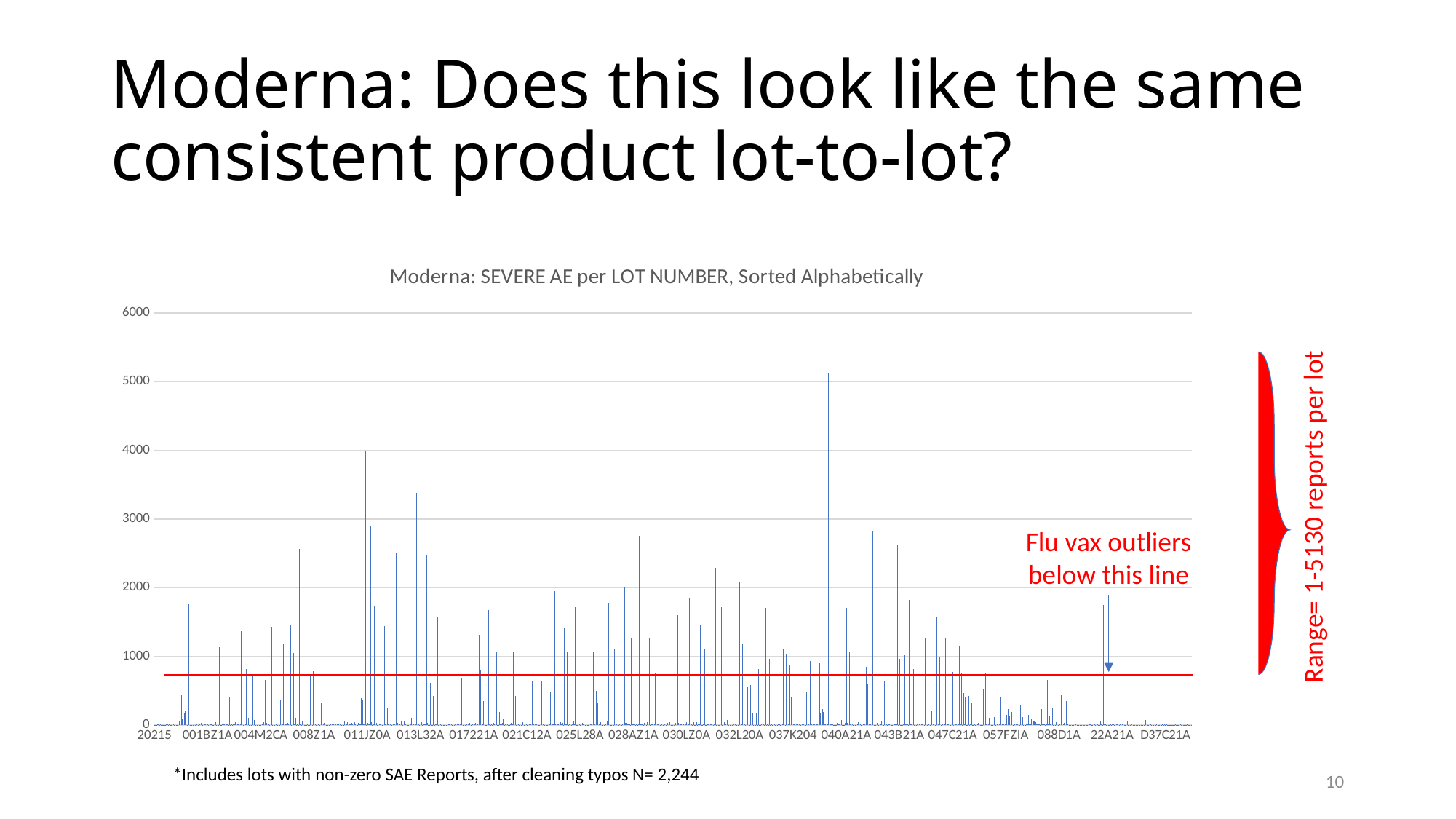
What is the last lot number label shown on the horizontal axis? D37C21A What kind of chart is shown on the slide? bar chart What is the highest value shown on the chart's vertical axis? 6000 What is the title of the chart? Moderna: SEVERE AE per LOT NUMBER, Sorted Alphabetically Is the tallest bar on the chart greater or less than 6000? less Is the horizontal red line on the chart drawn at a value greater or less than 1000? less According to the red annotation beside the chart, what is the range of reports per lot? 1-5130 reports per lot According to the footnote below the chart, how many lots with non-zero SAE reports are included? 2,244 What is the first lot number label shown on the horizontal axis? 20215 What does the red text on the chart say lies below the red line? Flu vax outliers Is the tallest bar on the chart greater or less than 5000? greater